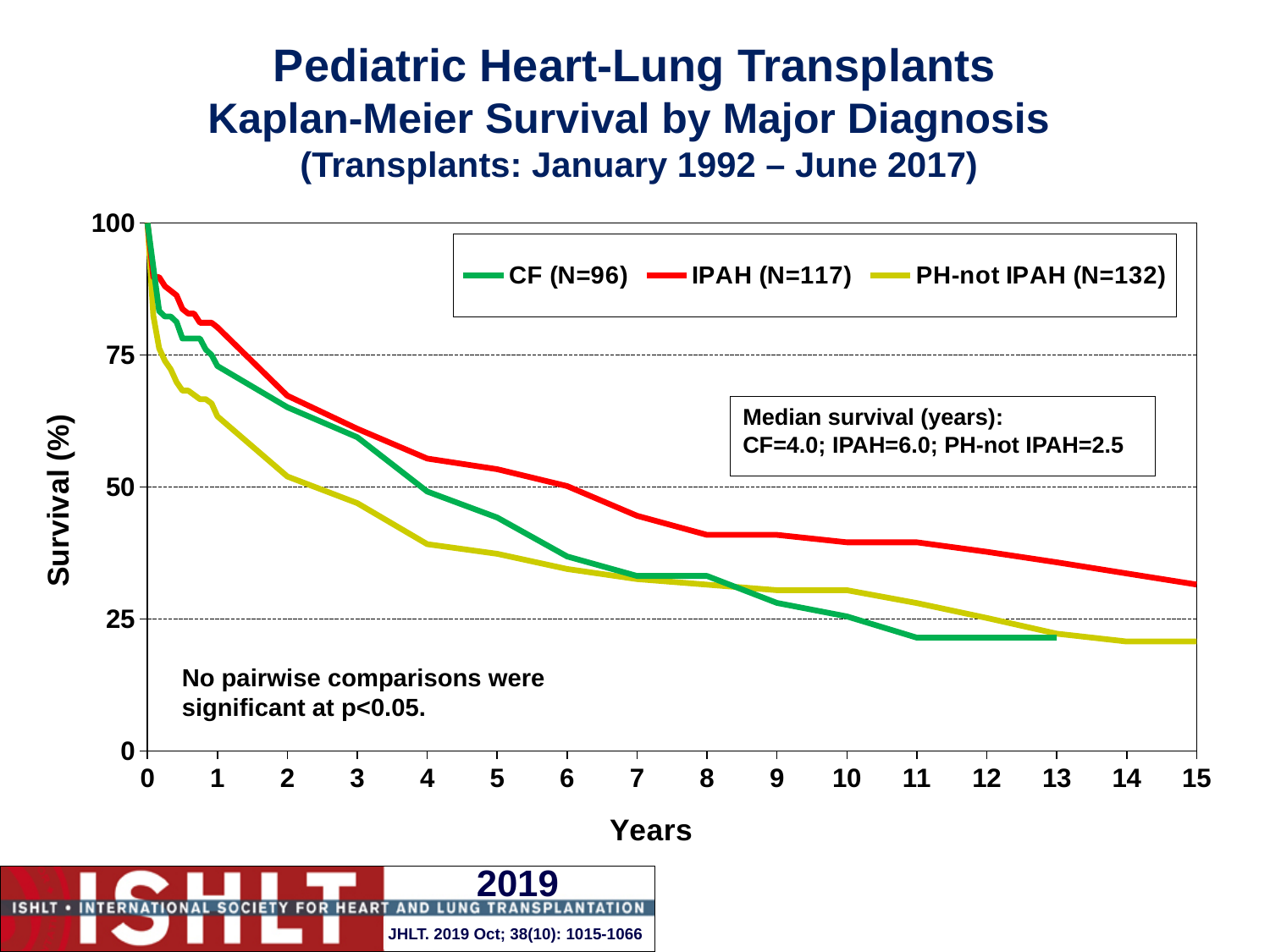
What is the median survival in years for the IPAH group, as stated on the slide? 6.0 How many series does the legend list? 3 What is the median survival in years for the PH-not IPAH group, as stated on the slide? 2.5 What is the difference in median survival (years) between the IPAH and CF groups? 2.0 What kind of chart is shown on the slide? Line chart Is the survival for IPAH at 15 years greater or less than 25? greater At 15 years, which group has higher survival, IPAH or PH-not IPAH? IPAH Which diagnosis group has the lowest median survival? PH-not IPAH Do the survival curves rise or fall as years increase? Fall What is the median survival in years for the CF group, as stated on the slide? 4.0 Which diagnosis group has the highest median survival? IPAH Is the survival for PH-not IPAH at 4 years greater or less than 50? less